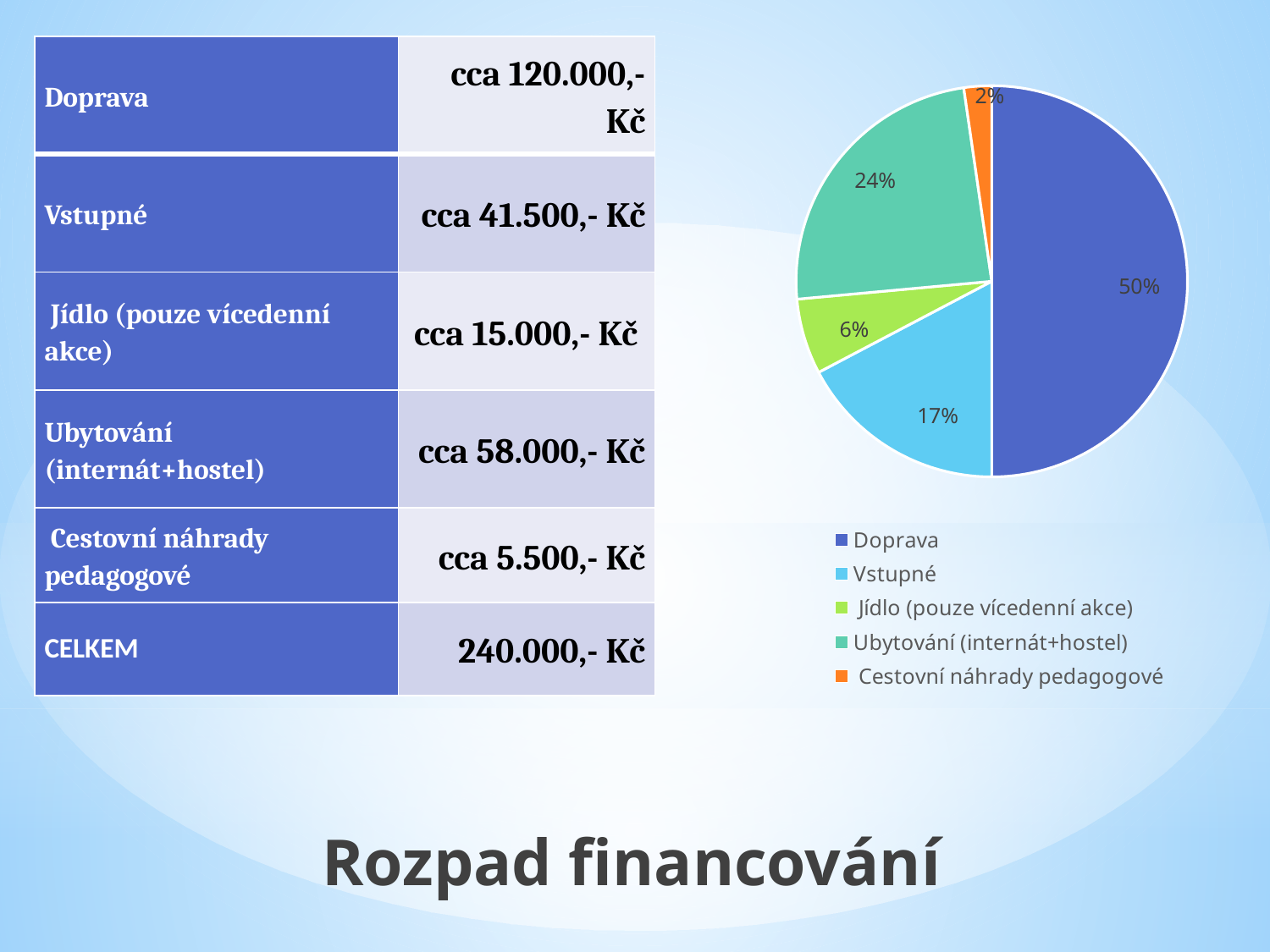
What share of the pie chart does Vstupné represent? 17% Which category has the largest slice in the pie chart? Doprava What is the difference in percentage points between the Doprava slice and the Ubytování (internát+hostel) slice? 26 What colour is the Cestovní náhrady pedagogové slice in the pie chart? orange What share of the pie chart does Ubytování (internát+hostel) represent? 24% What share of the pie chart does Jídlo (pouze vícedenní akce) represent? 6% Which category has the smallest slice in the pie chart? Cestovní náhrady pedagogové What type of chart is shown on the slide? pie chart How many categories does the pie chart show? 5 Which slice is larger in the pie chart, Vstupné or Jídlo (pouze vícedenní akce)? Vstupné